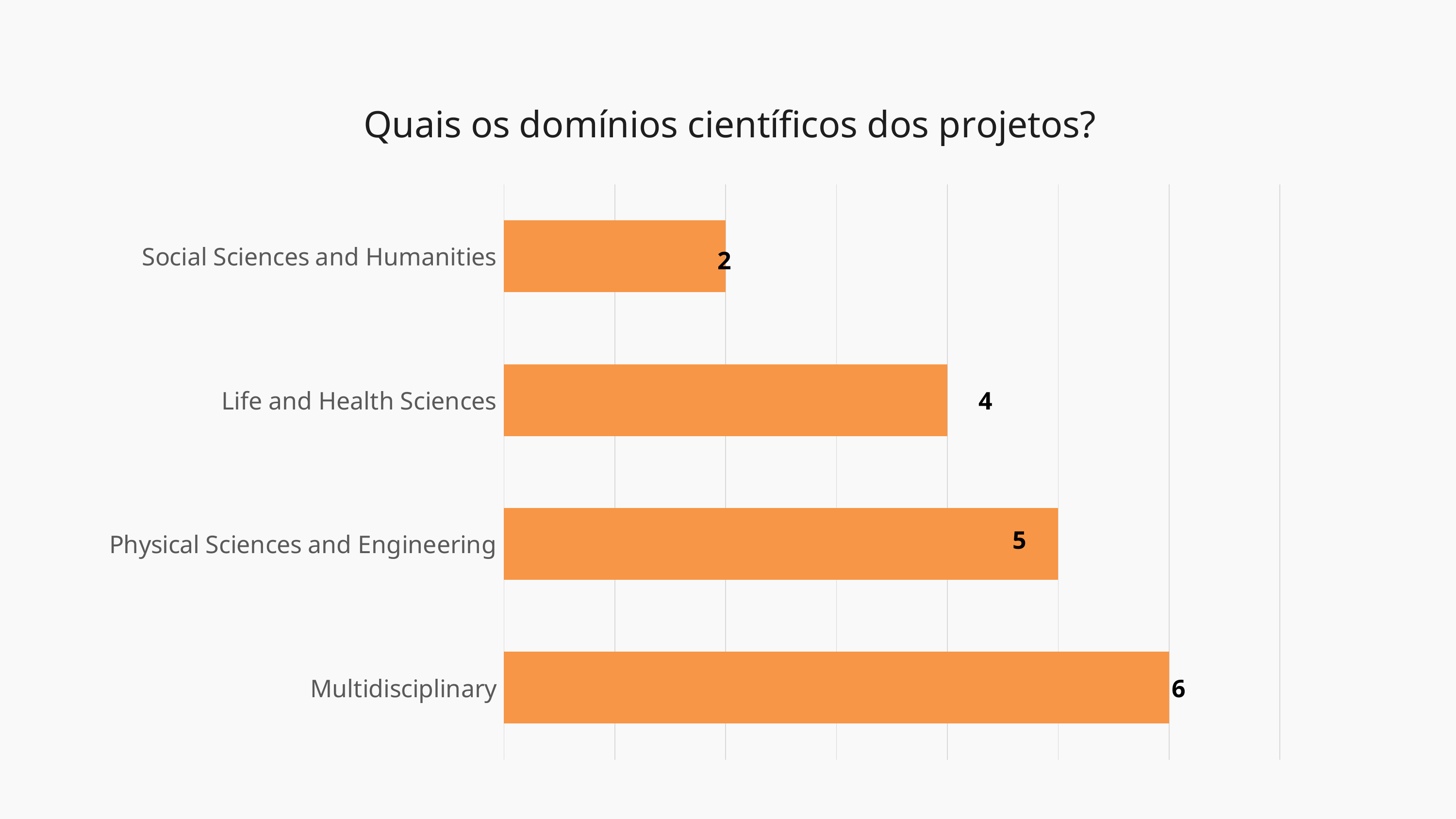
What is the value for Physical Sciences and Engineering? 5 Which is larger, the value for Life and Health Sciences or the value for Physical Sciences and Engineering? Physical Sciences and Engineering What is the difference between the values for Physical Sciences and Engineering and Life and Health Sciences? 1 What is the value for Multidisciplinary? 6 What kind of chart is shown on the slide? bar chart What is the title of the chart? Quais os domínios científicos dos projetos? What is the difference between the values for Multidisciplinary and Social Sciences and Humanities? 4 Which category has the lowest value? Social Sciences and Humanities What is the value for Life and Health Sciences? 4 Which category has the highest value? Multidisciplinary What is the value for Social Sciences and Humanities? 2 How many categories are shown in the chart? 4